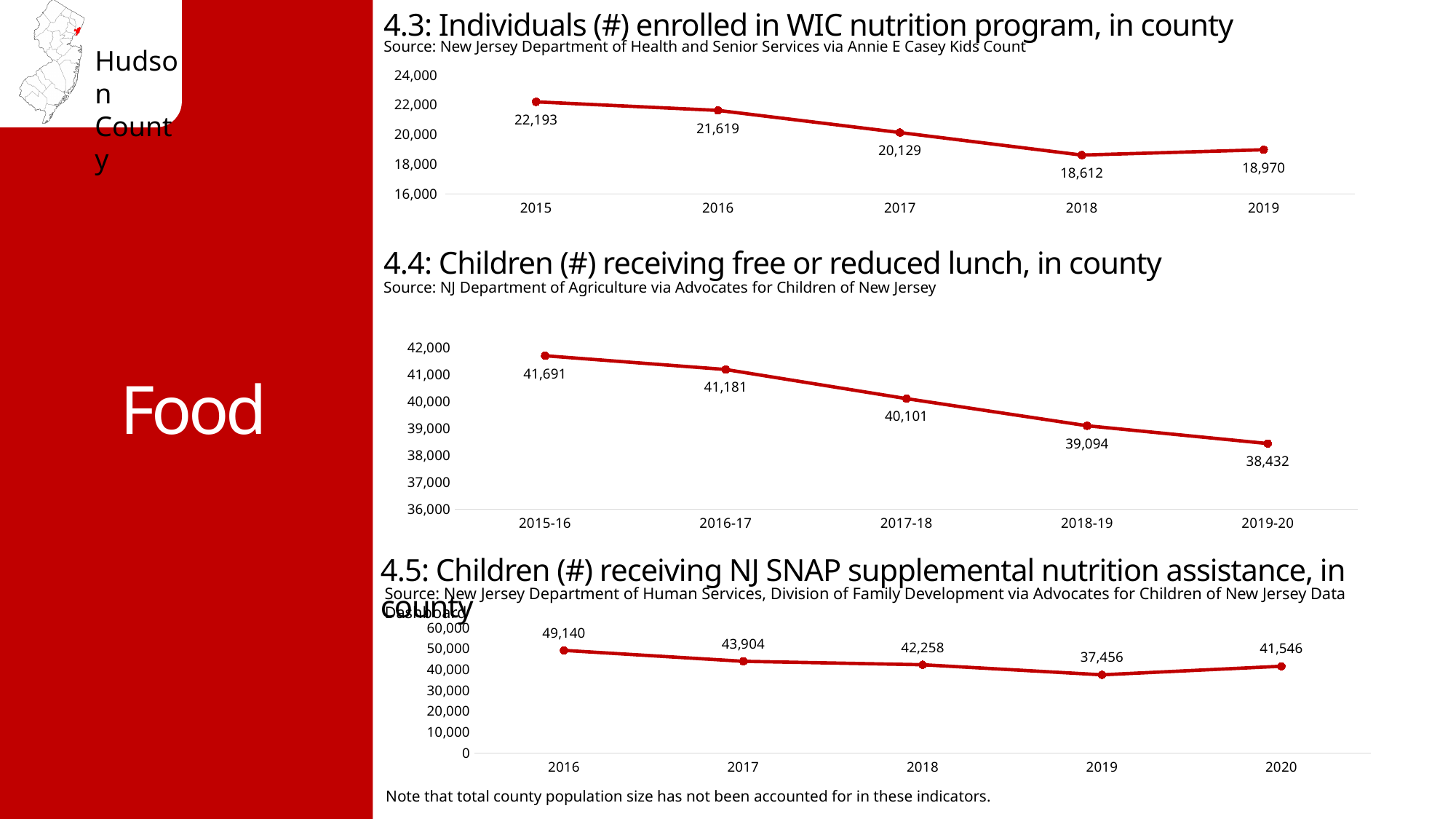
In the chart '4.5: Children (#) receiving NJ SNAP supplemental nutrition assistance, in county', what is the value for 2016? 49,140 In the chart '4.3: Individuals (#) enrolled in WIC nutrition program, in county', what is the value for 2017? 20,129 In the chart '4.5: Children (#) receiving NJ SNAP supplemental nutrition assistance, in county', which is larger, the value for 2017 or the value for 2020? 2017 In the chart '4.3: Individuals (#) enrolled in WIC nutrition program, in county', what is the difference between the 2015 and 2019 values? 3,223 In the chart '4.4: Children (#) receiving free or reduced lunch, in county', what is the value for 2018-19? 39,094 In the chart '4.4: Children (#) receiving free or reduced lunch, in county', which school year has the highest value? 2015-16 What type of chart is '4.3: Individuals (#) enrolled in WIC nutrition program, in county'? line chart In the chart '4.5: Children (#) receiving NJ SNAP supplemental nutrition assistance, in county', what is the difference between the 2019 and 2020 values? 4,090 In the chart '4.5: Children (#) receiving NJ SNAP supplemental nutrition assistance, in county', which year has the lowest value? 2019 In the chart '4.4: Children (#) receiving free or reduced lunch, in county', do the values rise or fall from 2015-16 to 2019-20? fall In the chart '4.3: Individuals (#) enrolled in WIC nutrition program, in county', which year has the lowest value? 2018 How many data points are plotted in the chart '4.4: Children (#) receiving free or reduced lunch, in county'? 5